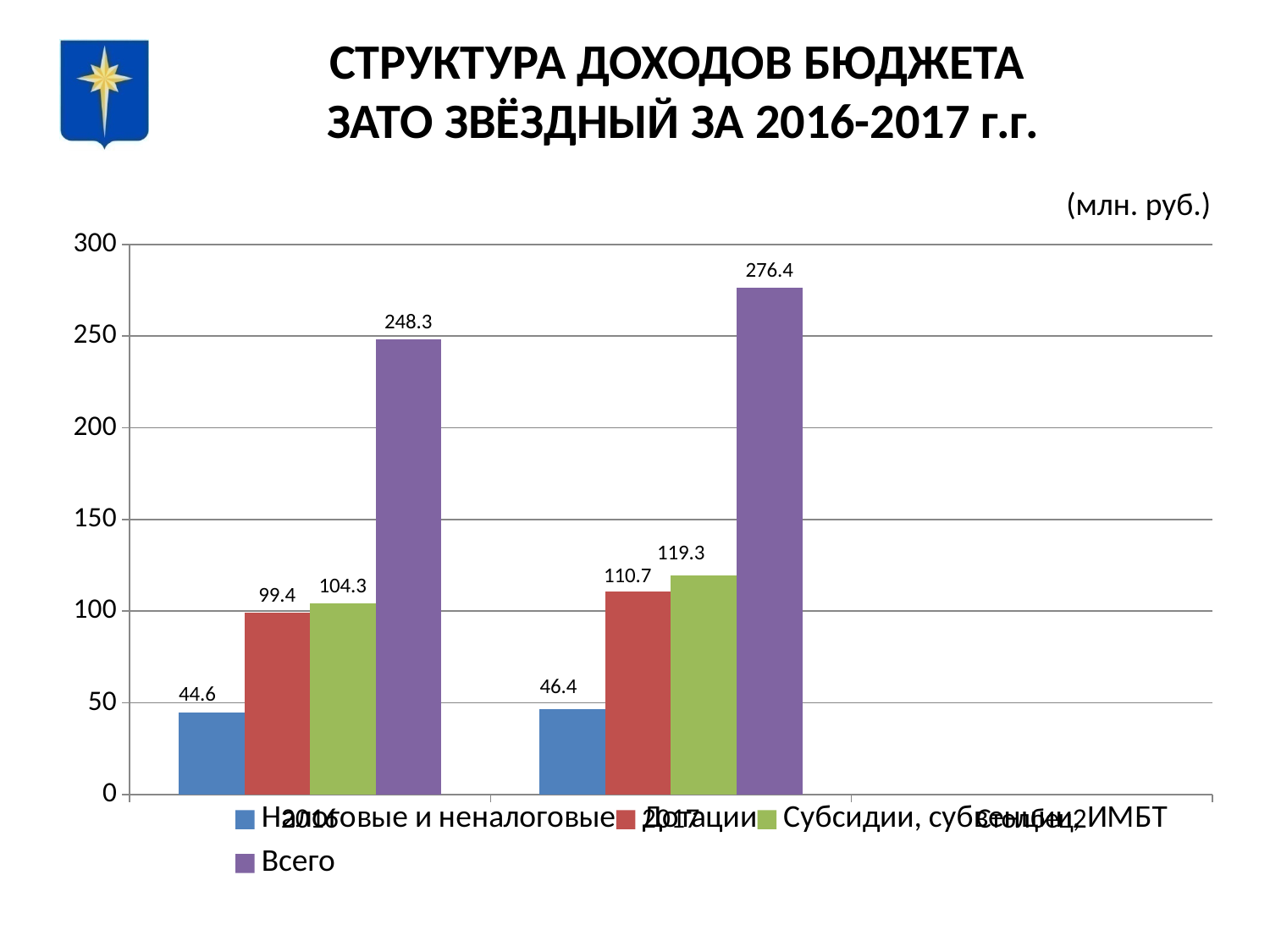
In 2016, which is larger: Дотации or Субсидии, субвенции, ИМБТ? Субсидии, субвенции, ИМБТ Which year has the higher value for Всего, 2016 or 2017? 2017 What is the value of Дотации for 2017? 110.7 What kind of chart is shown on the slide? bar chart Which series has the lowest value in 2017? Налоговые и неналоговые What is the value of Субсидии, субвенции, ИМБТ for 2017? 119.3 What is the value of Всего for 2016? 248.3 What is the difference between Дотации in 2017 and Дотации in 2016? 11.3 What is the value of Налоговые и неналоговые for 2016? 44.6 How many series does the legend list? 4 By how much did Всего increase from 2016 to 2017? 28.1 What unit of measurement is indicated for the chart values? млн. руб.